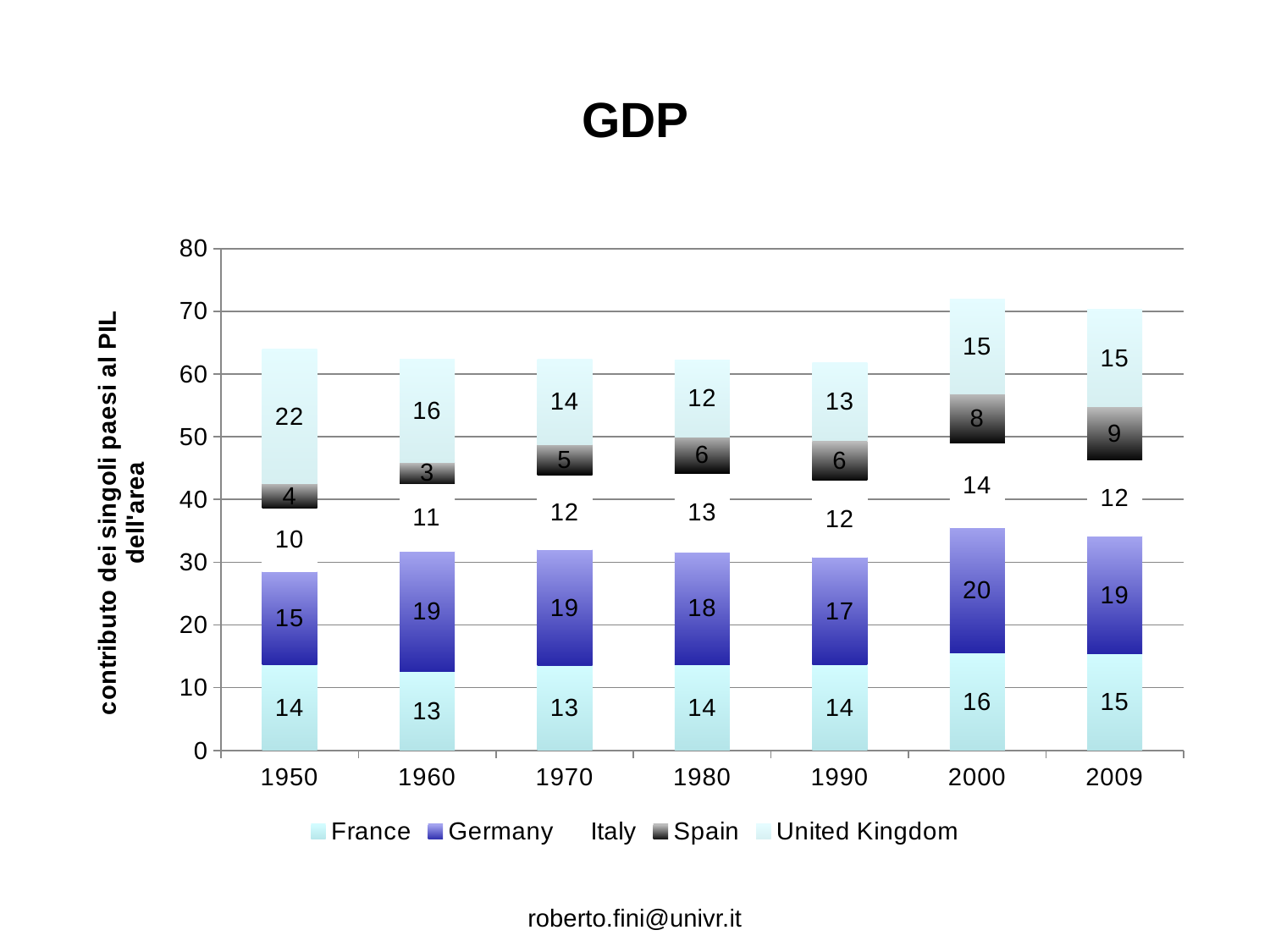
In 1970, which is larger: the value for Germany or the value for France? Germany How many series does the legend list? 5 What kind of chart is shown on the slide? Stacked bar chart What is the title of the chart? GDP Do the values for Spain generally rise or fall from 1950 to 2009? Rise What is the value for Spain in 1960? 3 What is the value for Germany in 2000? 20 What is the difference between the United Kingdom value in 1950 and in 2009? 7 In which year is the value for Italy lowest? 1950 In which year is the value for Spain highest? 2009 How many years are shown on the x axis? 7 What is the value for United Kingdom in 1950? 22